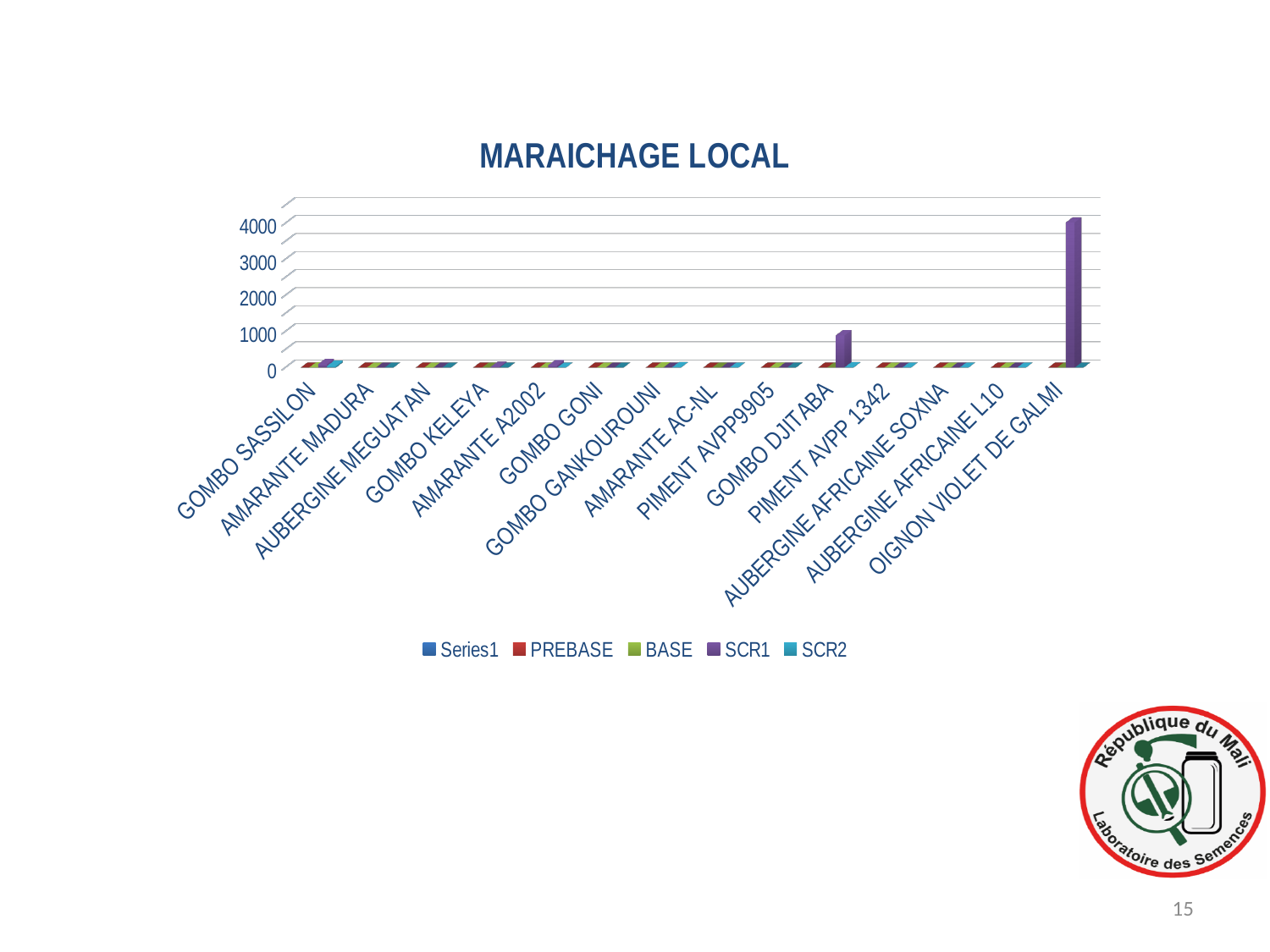
Is the SCR1 value for GOMBO DJITABA greater or less than 2000? less Which has a larger SCR1 value, GOMBO DJITABA or PIMENT AVPP 1342? GOMBO DJITABA What type of chart is shown on the slide? Bar chart Is the SCR1 value for OIGNON VIOLET DE GALMI greater or less than 3000? greater What is the title of the chart? MARAICHAGE LOCAL How many categories are shown on the x axis? 14 Which has a larger SCR1 value, OIGNON VIOLET DE GALMI or GOMBO DJITABA? OIGNON VIOLET DE GALMI Which series has the tallest bar in the chart? SCR1 Which category has the highest SCR1 value? OIGNON VIOLET DE GALMI What is the highest value labelled on the vertical axis? 4000 How many series does the legend list? 5